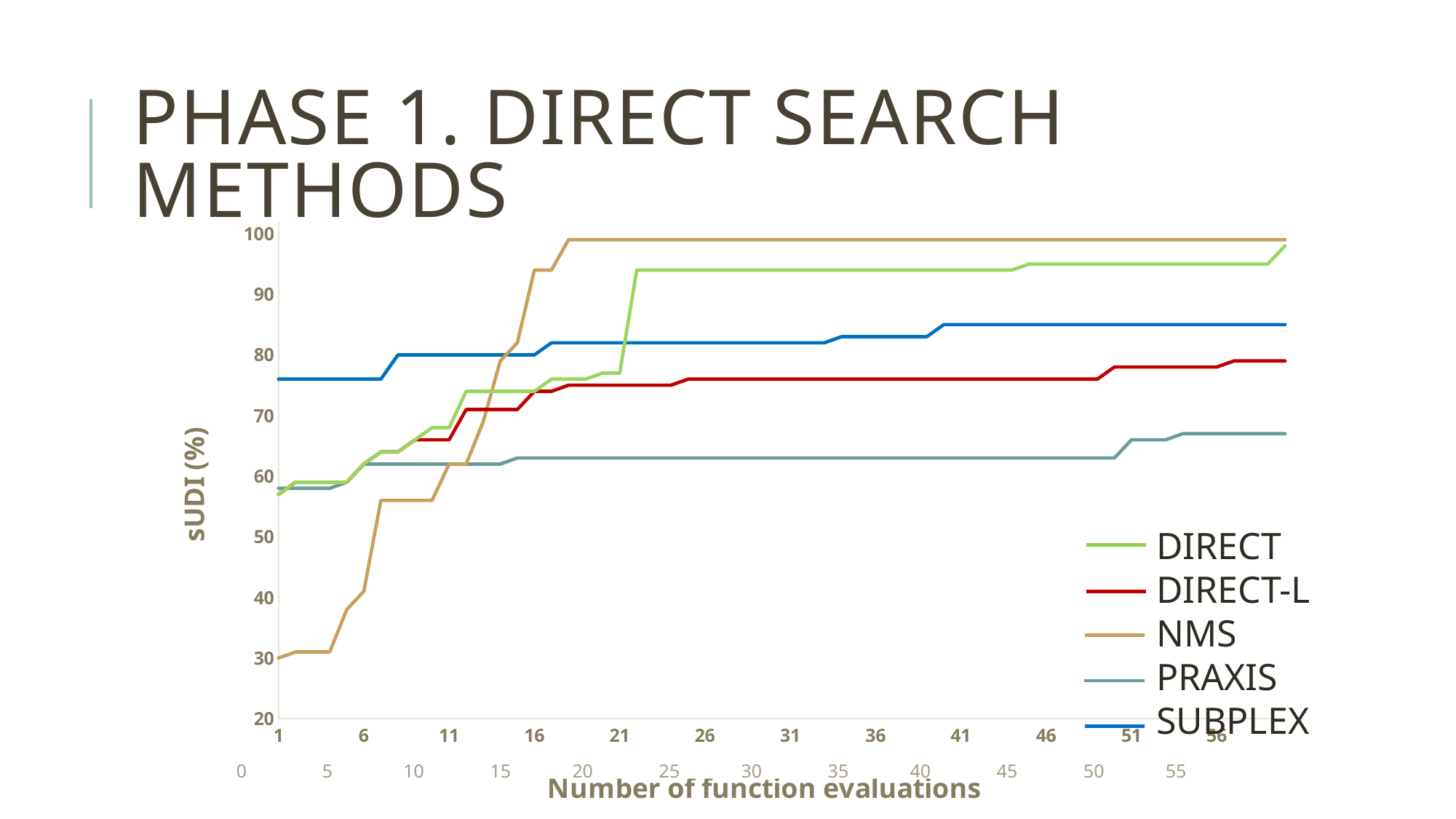
Does the NMS line rise or fall as the number of function evaluations increases? rise Is the value for PRAXIS at 30 function evaluations greater or less than 70? less At 1 function evaluation, which is larger, SUBPLEX or NMS? SUBPLEX What is the label of the vertical axis? sUDI (%) What kind of chart is shown on the slide? line chart Which series has the lowest sUDI value at the right end of the chart? PRAXIS How many series does the legend list? 5 At 56 function evaluations, which is larger, DIRECT-L or PRAXIS? DIRECT-L What is the label of the horizontal axis? Number of function evaluations Which series reaches the highest sUDI value at the right end of the chart? NMS Is the value for NMS at 1 function evaluation greater or less than 40? less Is the value for SUBPLEX at 1 function evaluation greater or less than 70? greater